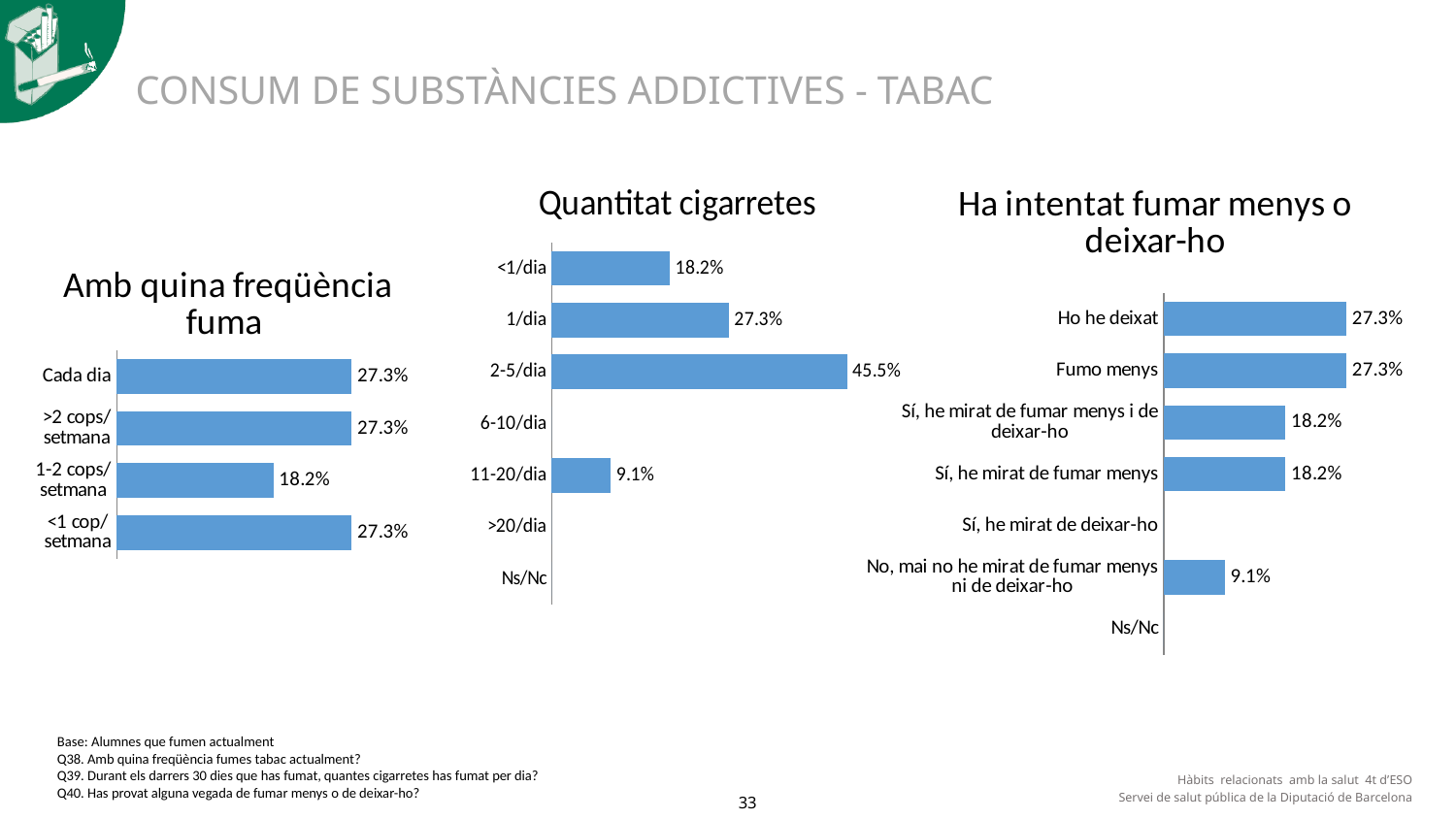
In the 'Amb quina freqüència fuma' chart, what is the value for '1-2 cops/setmana'? 18.2% In the 'Quantitat cigarretes' chart, which category has the highest value? 2-5/dia In the 'Ha intentat fumar menys o deixar-ho' chart, what is the value for 'No, mai no he mirat de fumar menys ni de deixar-ho'? 9.1% In the 'Amb quina freqüència fuma' chart, which category has the lowest value? 1-2 cops/setmana In the 'Quantitat cigarretes' chart, which is larger, '<1/dia' or '11-20/dia'? <1/dia In the 'Ha intentat fumar menys o deixar-ho' chart, what is the difference between 'Fumo menys' and 'Sí, he mirat de fumar menys'? 9.1% What type of chart is the 'Quantitat cigarretes' chart? Bar chart In the 'Ha intentat fumar menys o deixar-ho' chart, what is the value for 'Ho he deixat'? 27.3% How many categories are shown in the 'Amb quina freqüència fuma' chart? 4 In the 'Quantitat cigarretes' chart, what is the difference between '2-5/dia' and '1/dia'? 18.2% How many categories are listed in the 'Quantitat cigarretes' chart? 7 In the 'Quantitat cigarretes' chart, what is the value for '2-5/dia'? 45.5%